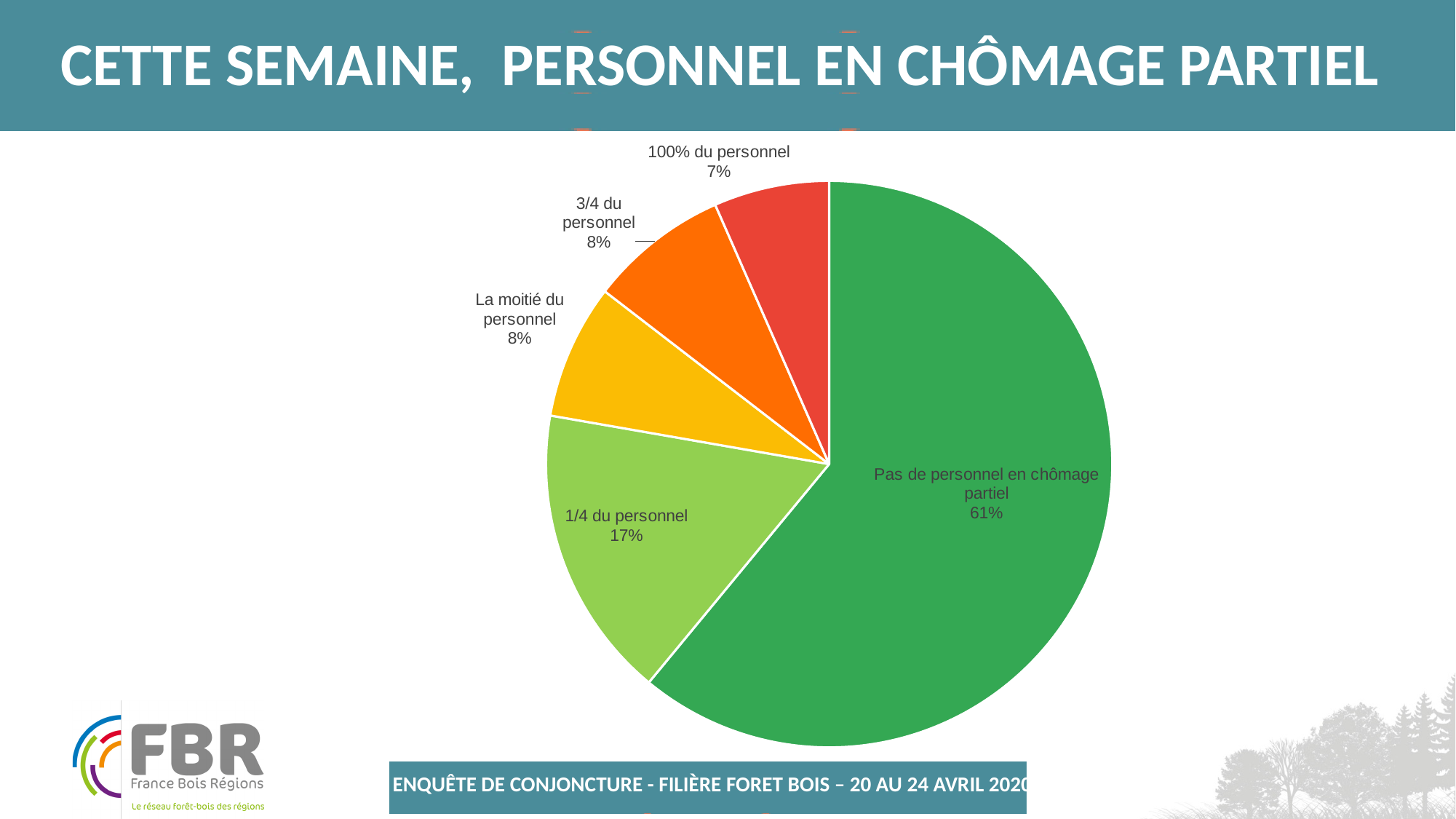
What is the title of the slide? CETTE SEMAINE, PERSONNEL EN CHÔMAGE PARTIEL What percentage is shown for '100% du personnel'? 7% What percentage is shown for 'La moitié du personnel'? 8% What share of the pie is labelled 'Pas de personnel en chômage partiel'? 61% What kind of chart is shown on the slide? Pie chart What is the difference in percentage points between 'Pas de personnel en chômage partiel' and '1/4 du personnel'? 44 What colour is the slice for '100% du personnel'? Red What percentage is shown for '1/4 du personnel'? 17% How many slices does the pie chart have? 5 Which category has the largest slice of the pie? Pas de personnel en chômage partiel Which category has the smallest slice of the pie? 100% du personnel Which is larger, the slice for '1/4 du personnel' or the slice for '3/4 du personnel'? 1/4 du personnel